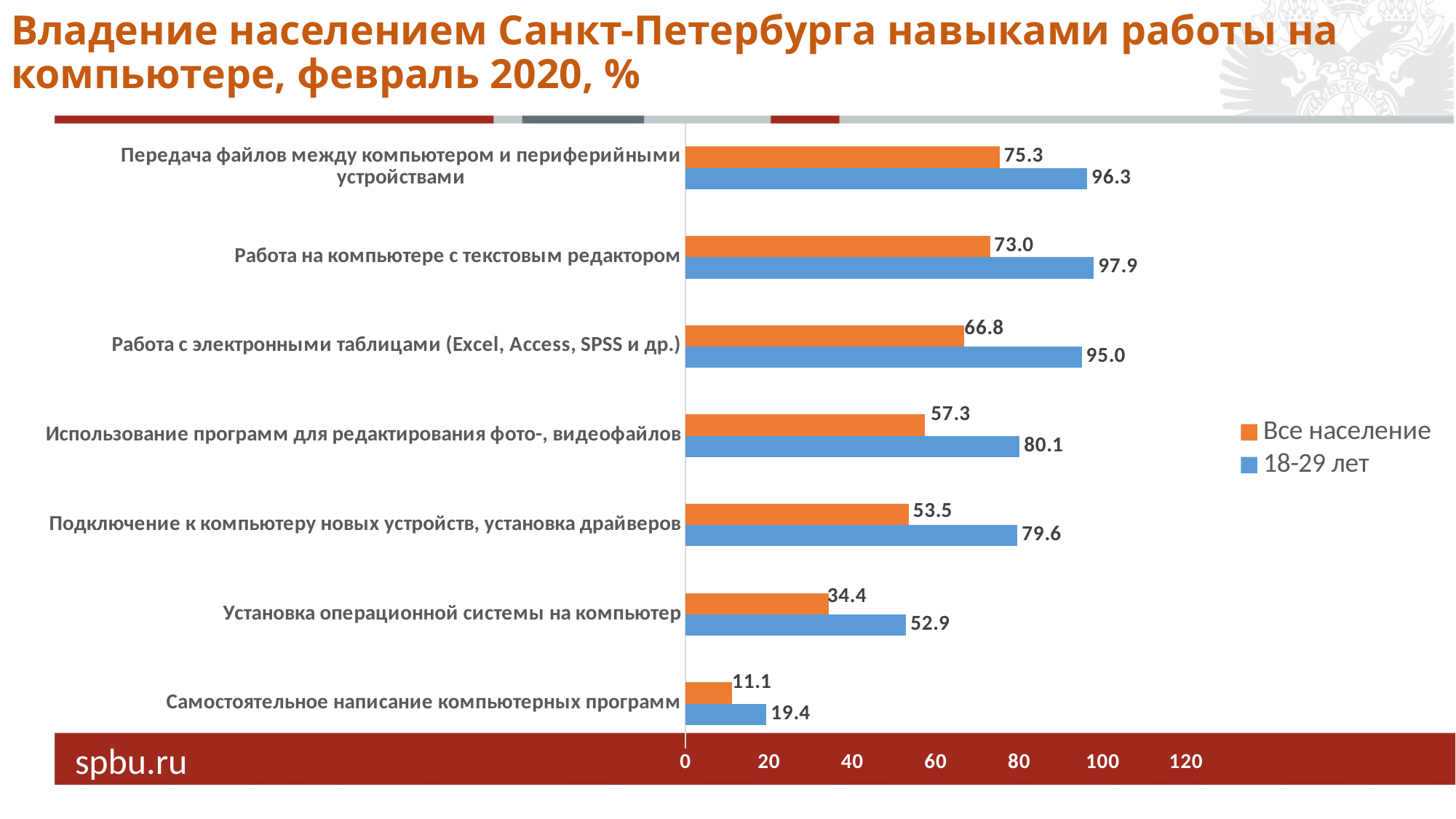
How many categories are shown on the chart? 7 What is the value for "18-29 лет" for "Самостоятельное написание компьютерных программ"? 19.4 What is the difference between the "18-29 лет" and "Все население" values for "Работа с электронными таблицами (Excel, Access, SPSS и др.)"? 28.2 Which category has the lowest value for the "Все население" series? Самостоятельное написание компьютерных программ What kind of chart is shown on the slide? bar chart Which category has the highest value for the "18-29 лет" series? Работа на компьютере с текстовым редактором What is the value for "Все население" for "Работа на компьютере с текстовым редактором"? 73.0 What is the value for "18-29 лет" for "Установка операционной системы на компьютер"? 52.9 Which is larger for "Использование программ для редактирования фото-, видеофайлов": the value for "Все население" or for "18-29 лет"? 18-29 лет Is the "Все население" value for "Подключение к компьютеру новых устройств, установка драйверов" greater or less than 60? less Which colour represents the "18-29 лет" series? blue How many series does the legend list? 2